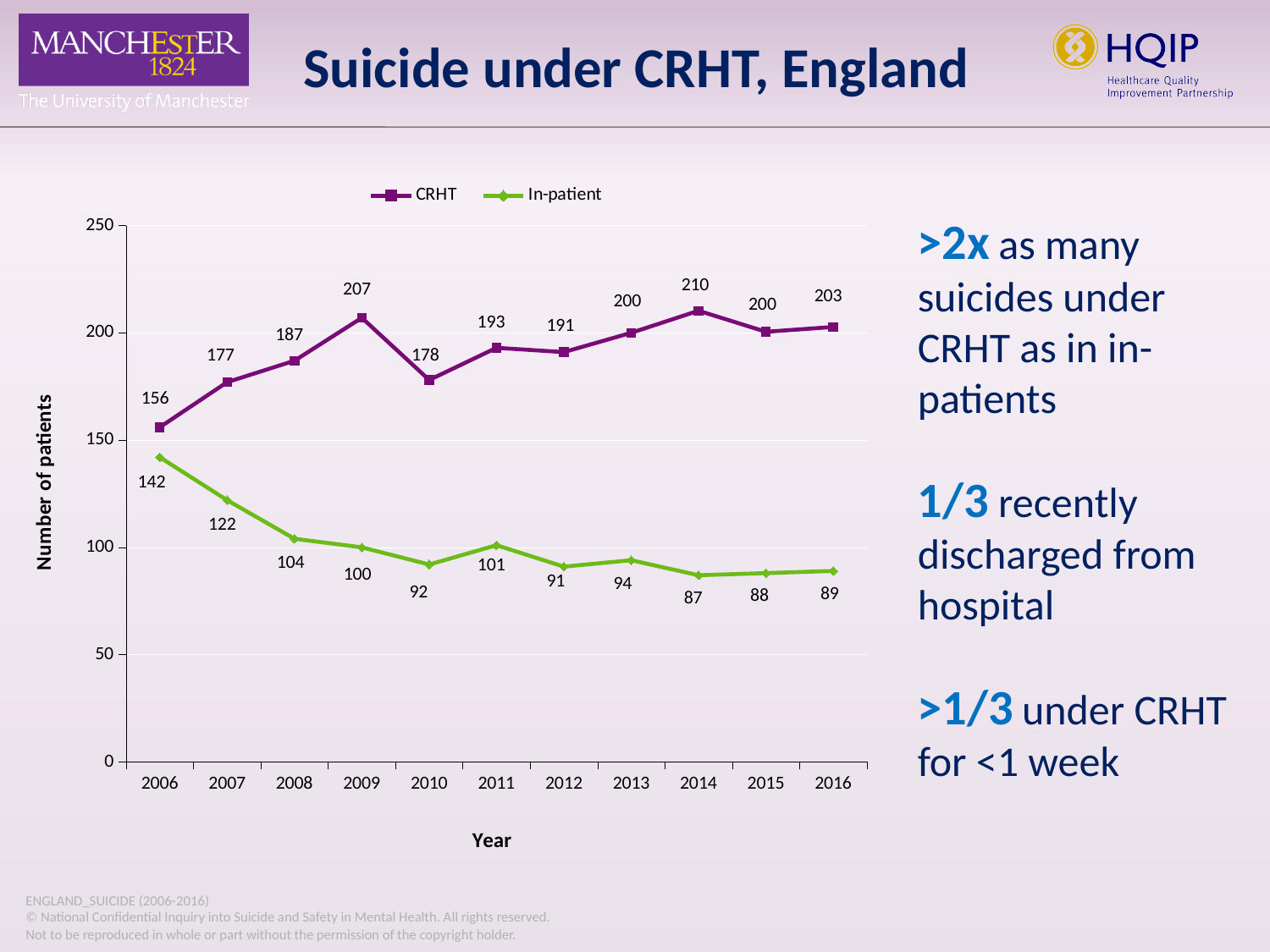
What is the difference between the CRHT and In-patient values in 2016? 114 How many years are shown on the x axis? 11 Which is larger, the In-patient value for 2006 or the In-patient value for 2007? 2006 What kind of chart is shown? Line chart What is the In-patient value for 2010? 92 In which year is the CRHT series highest? 2014 How many series does the legend list? 2 What is the CRHT value for 2009? 207 Is the CRHT value for 2010 greater or less than 150? greater Does the In-patient series generally rise or fall from 2006 to 2016? Fall In which year is the In-patient series lowest? 2014 What is the CRHT value for 2006? 156